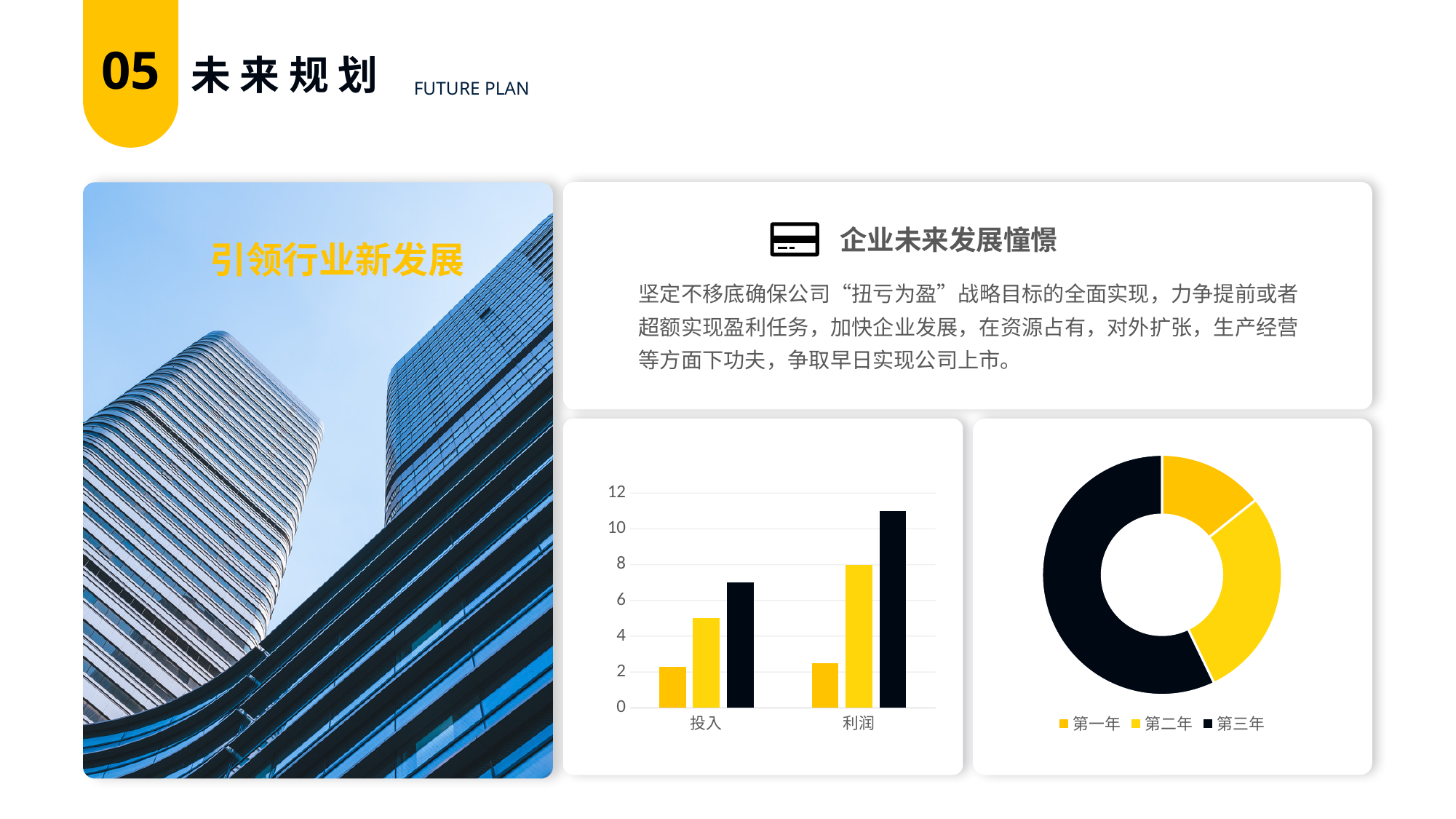
In the donut chart, which series has the largest share? 第三年 How many series does the legend of the donut chart list? 3 In the bar chart, is the tallest bar for 投入 greater or less than 6? greater In the bar chart, what are the two categories on the x axis? 投入 and 利润 What kind of chart is the chart on the bottom right of the slide? donut chart In the bar chart, is the shortest bar for 投入 greater or less than 4? less What kind of chart is the chart on the bottom left of the slide? bar chart In the bar chart, is the tallest bar for 利润 greater or less than 10? greater In the bar chart, how many categories are shown on the x axis? 2 In the bar chart, what is the highest value shown on the vertical axis? 12 In the bar chart, which category has the tallest bar? 利润 In the bar chart, which category has the larger black bar, 投入 or 利润? 利润